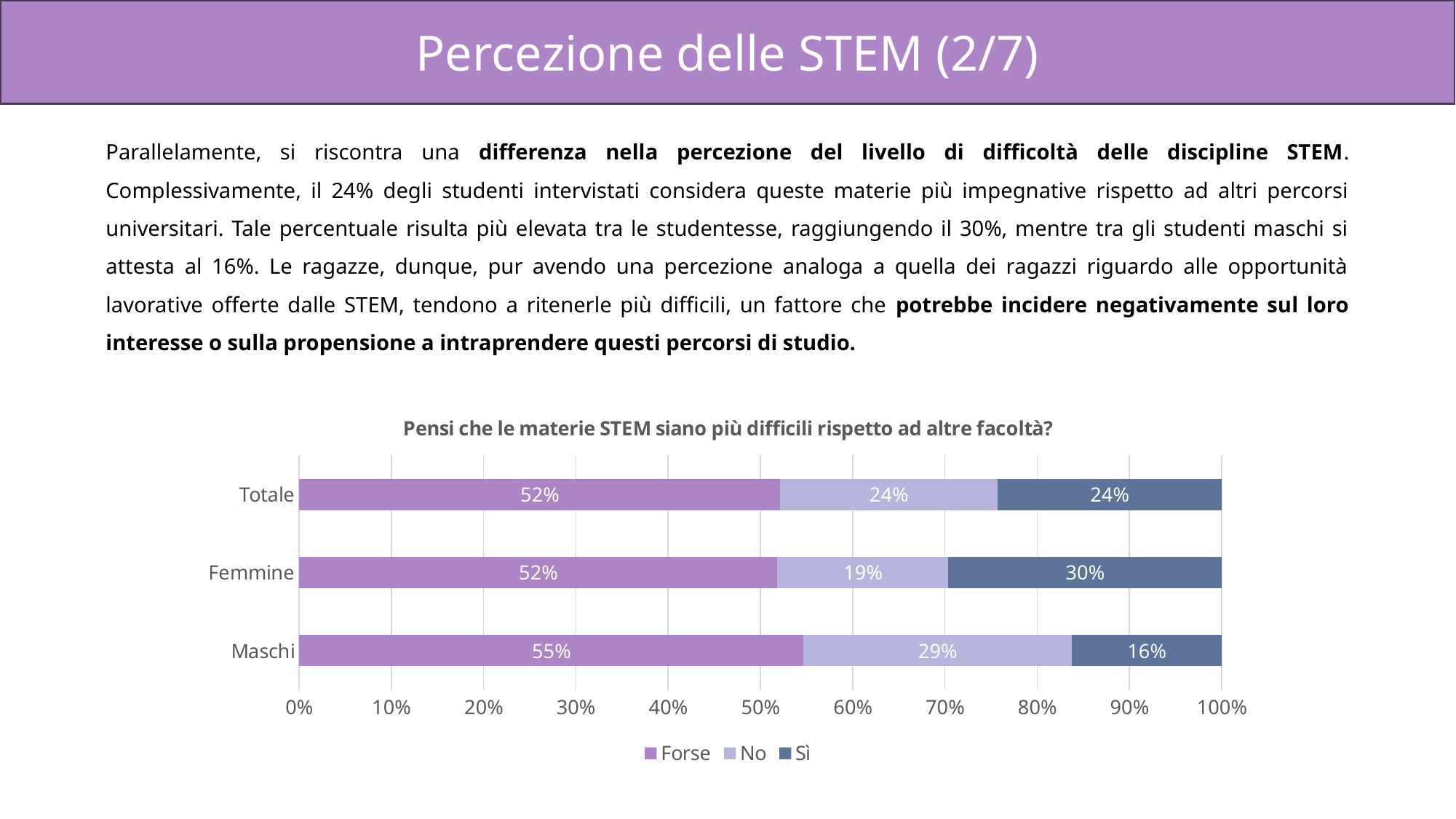
Which category has the highest value for "Sì"? Femmine What is the total of the Maschi stacked bar? 100% What is the value for "Forse" in the Totale bar? 52% How many categories are shown on the y axis? 3 Which category has the lowest value for "No"? Femmine How many series does the legend list? 3 What is the title of the chart? Pensi che le materie STEM siano più difficili rispetto ad altre facoltà? What is the difference between the "Sì" values for Femmine and Maschi? 14% What kind of chart is shown? Stacked bar chart Which is larger: the "Forse" value for Maschi or for Femmine? Maschi What is the value for "Sì" in the Femmine bar? 30% What is the value for "No" in the Maschi bar? 29%